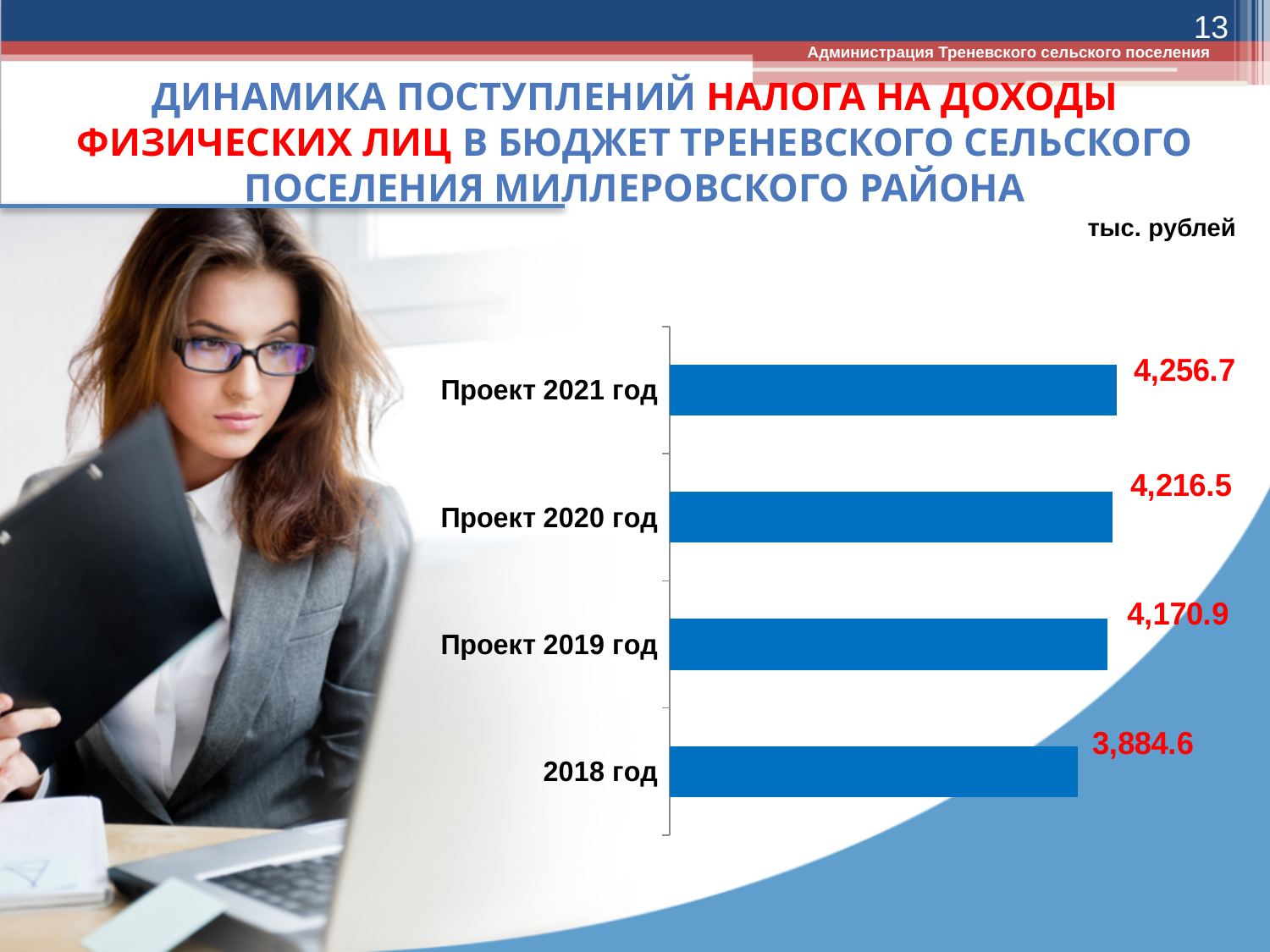
What is the value for Проект 2021 год? 4,256.7 What is the value for Проект 2019 год? 4,170.9 What is the difference between the values for Проект 2020 год and Проект 2019 год? 45.6 What kind of chart is shown on the slide? Bar chart Which category has the highest value? Проект 2021 год What is the difference between the values for Проект 2021 год and 2018 год? 372.1 Which is larger, the value for Проект 2021 год or Проект 2020 год? Проект 2021 год What is the value for 2018 год? 3,884.6 Which category has the lowest value? 2018 год What is the value for Проект 2020 год? 4,216.5 Do the values rise or fall from 2018 год to Проект 2021 год? Rise How many categories are shown in the chart? 4